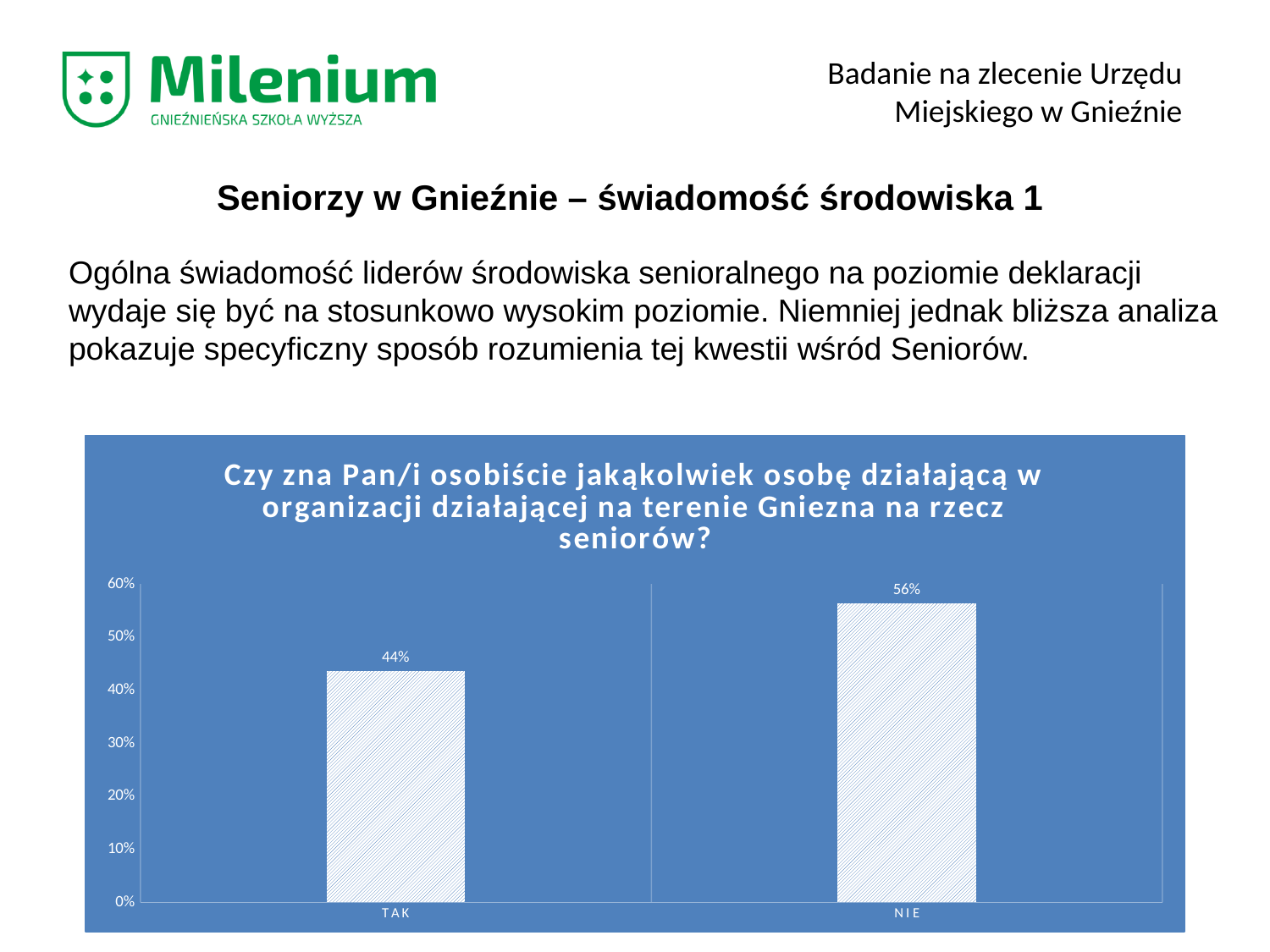
Is the value for TAK greater or less than 50%? less Which is larger, the value for TAK or the value for NIE? NIE Which category has the lowest value? TAK Is the value for NIE greater or less than 50%? greater What is the value for NIE? 56% What is the title of the chart? Czy zna Pan/i osobiście jakąkolwiek osobę działającą w organizacji działającej na terenie Gniezna na rzecz seniorów? What kind of chart is shown on the slide? bar chart What is the value for TAK? 44% How many categories are shown on the chart? 2 What is the highest value shown on the vertical axis of the chart? 60% Which category has the highest value? NIE What is the difference between the values for NIE and TAK? 12%